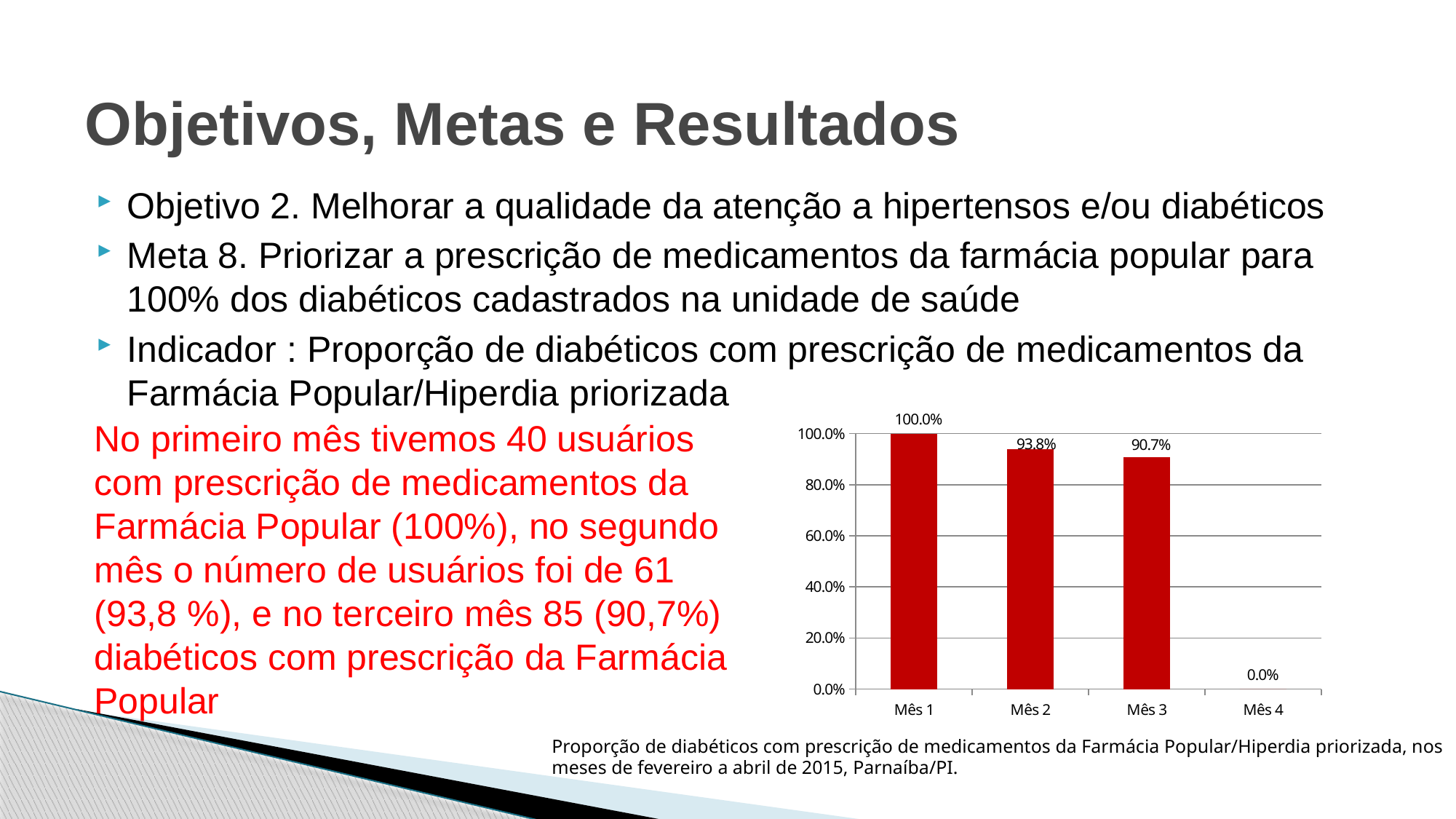
What is the value for Mês 1? 100.0% Do the values rise or fall from Mês 1 to Mês 3? Fall What is the difference between the values for Mês 1 and Mês 3? 9.3% Which month has the highest value? Mês 1 What kind of chart is shown on the slide? Bar chart What is the difference between the values for Mês 2 and Mês 3? 3.1% What is the value for Mês 3? 90.7% Which is larger, the value for Mês 2 or the value for Mês 3? Mês 2 What is the value for Mês 4? 0.0% How many months are shown on the x axis? 4 What is the value for Mês 2? 93.8% Which month has the lowest value? Mês 4